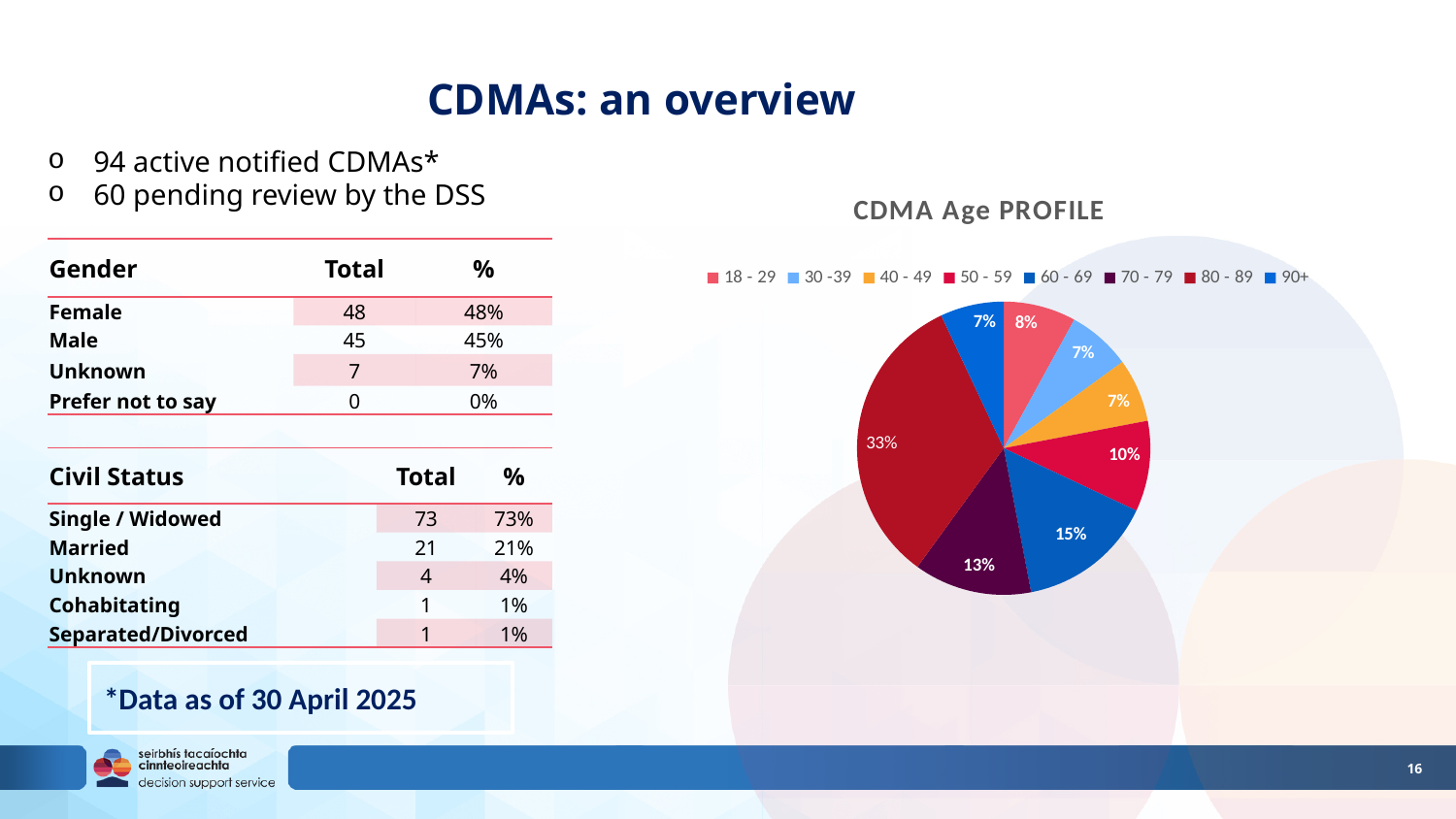
What is the difference in percentage points between the 80 - 89 share and the 60 - 69 share? 18 What percentage is shown for the 70 - 79 age group? 13% What is the combined share of the 18 - 29 and 30 -39 age groups? 15% Which is larger, the share for 60 - 69 or the share for 50 - 59? 60 - 69 What type of chart is shown on the slide? pie chart What percentage is shown for the 50 - 59 age group? 10% What share of the pie does the 80 - 89 age group represent? 33% How many age groups does the legend of the pie chart list? 8 What percentage is shown for the 18 - 29 age group? 8% What percentage is shown for the 60 - 69 age group? 15% What is the title of the chart? CDMA Age PROFILE Which age group has the largest share of the pie? 80 - 89